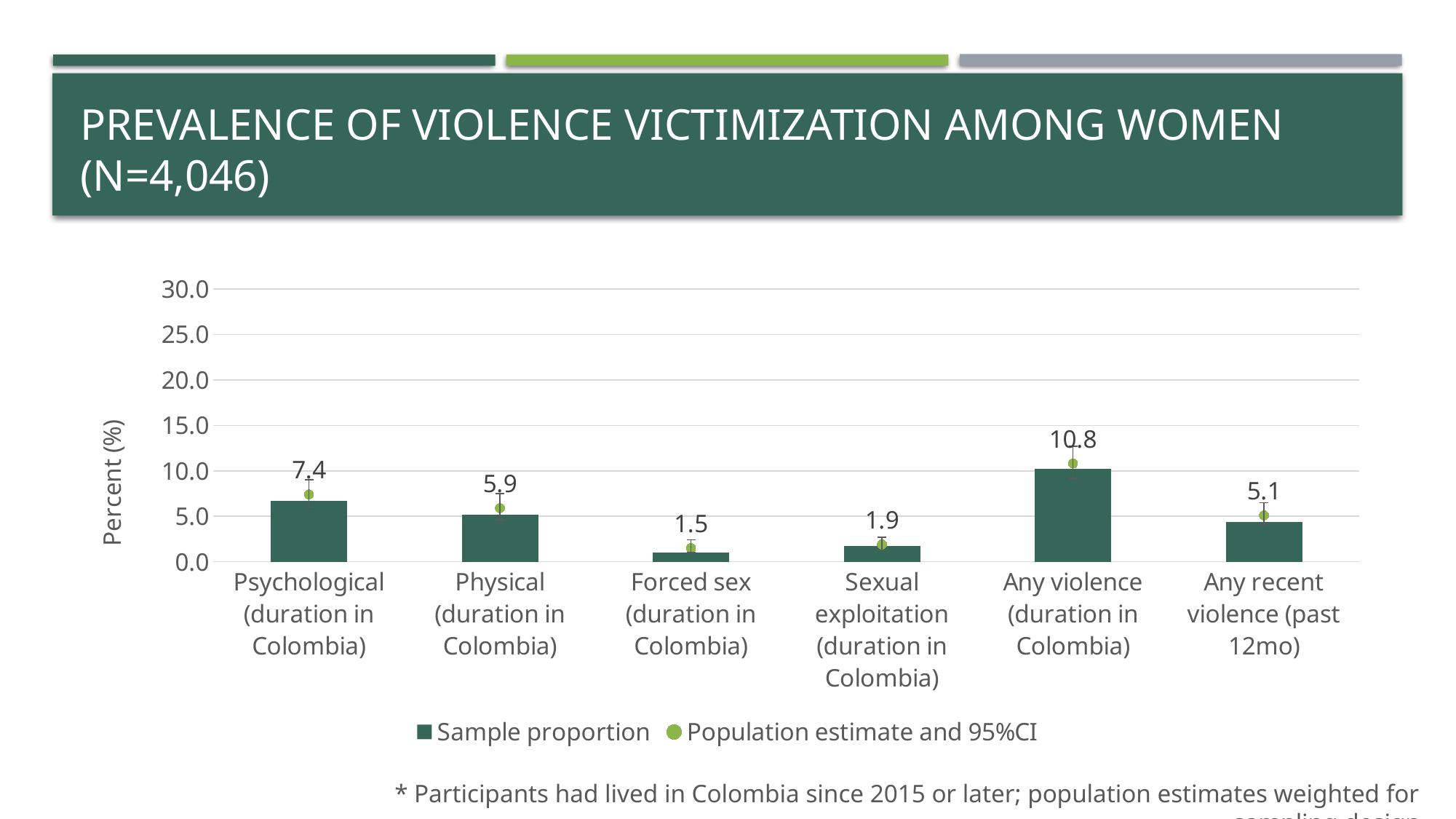
What is the population estimate for Any violence (duration in Colombia)? 10.8 How many categories are shown on the x axis? 6 What is the population estimate for Psychological (duration in Colombia)? 7.4 How many series does the legend list? 2 Which category has the highest population estimate? Any violence (duration in Colombia) What is the label of the y axis? Percent (%) What is the population estimate for Forced sex (duration in Colombia)? 1.5 What is the population estimate for Any recent violence (past 12mo)? 5.1 Which category has the lowest population estimate? Forced sex (duration in Colombia) Which has a larger population estimate, Physical (duration in Colombia) or Sexual exploitation (duration in Colombia)? Physical (duration in Colombia) What is the difference between the population estimates for Any violence (duration in Colombia) and Any recent violence (past 12mo)? 5.7